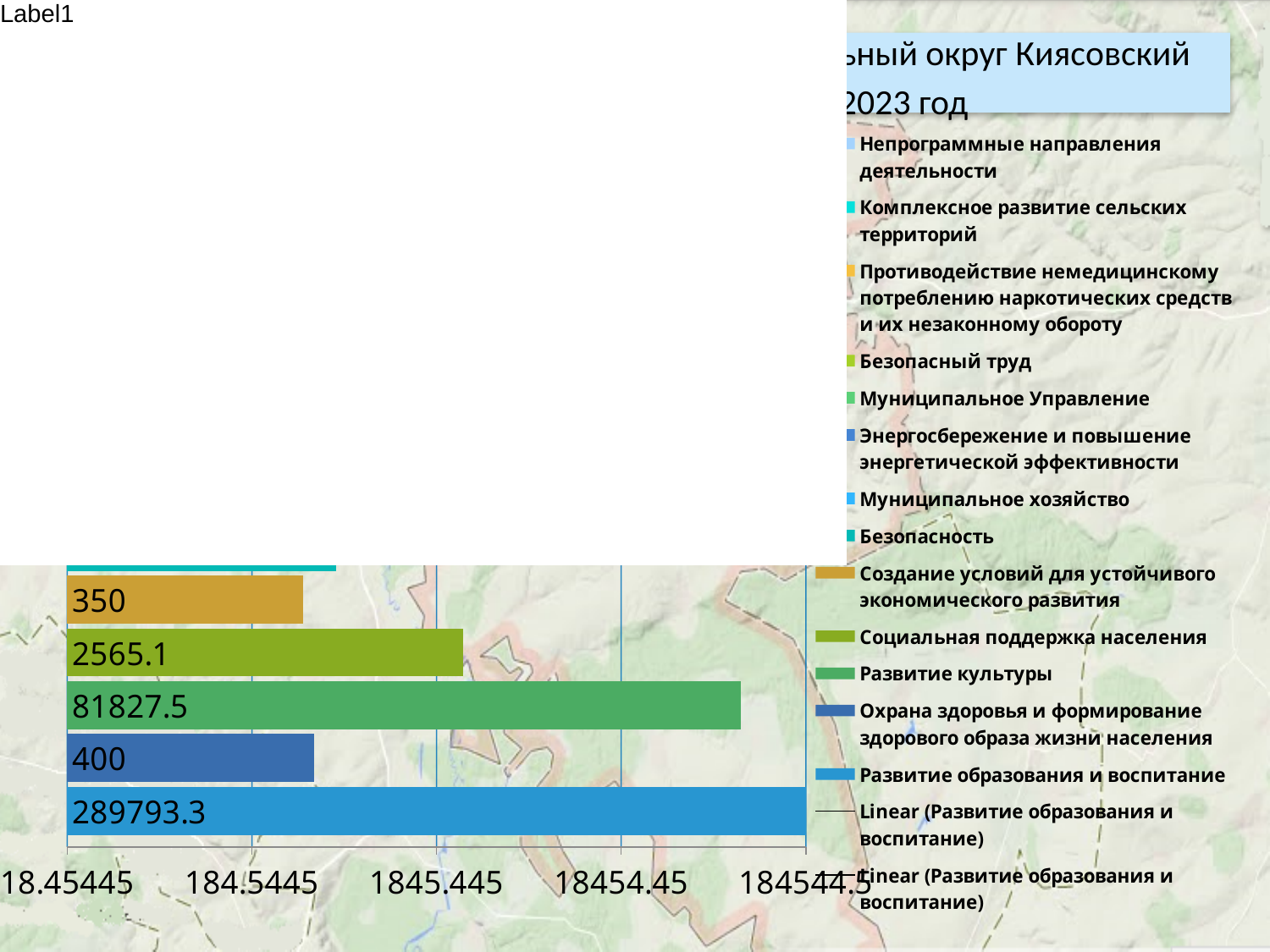
What is the value shown for Создание условий для устойчивого экономического развития? 350 Which is larger, the value for Охрана здоровья и формирование здорового образа жизни населения or for Создание условий для устойчивого экономического развития? Охрана здоровья и формирование здорового образа жизни населения Which of the labelled bars has the highest value? Развитие образования и воспитание Which is larger, the value for Развитие культуры or for Социальная поддержка населения? Развитие культуры What is the difference between the values for Развитие образования и воспитание and Развитие культуры? 207965.8 What is the value shown for Охрана здоровья и формирование здорового образа жизни населения? 400 What is the value shown for Социальная поддержка населения? 2565.1 How many 'Linear' trendline entries does the legend list? 2 What is the value shown for Развитие культуры? 81827.5 What is the difference between the values for Охрана здоровья и формирование здорового образа жизни населения and Создание условий для устойчивого экономического развития? 50 What is the value shown for Развитие образования и воспитание? 289793.3 What kind of chart is shown on the slide? Bar chart